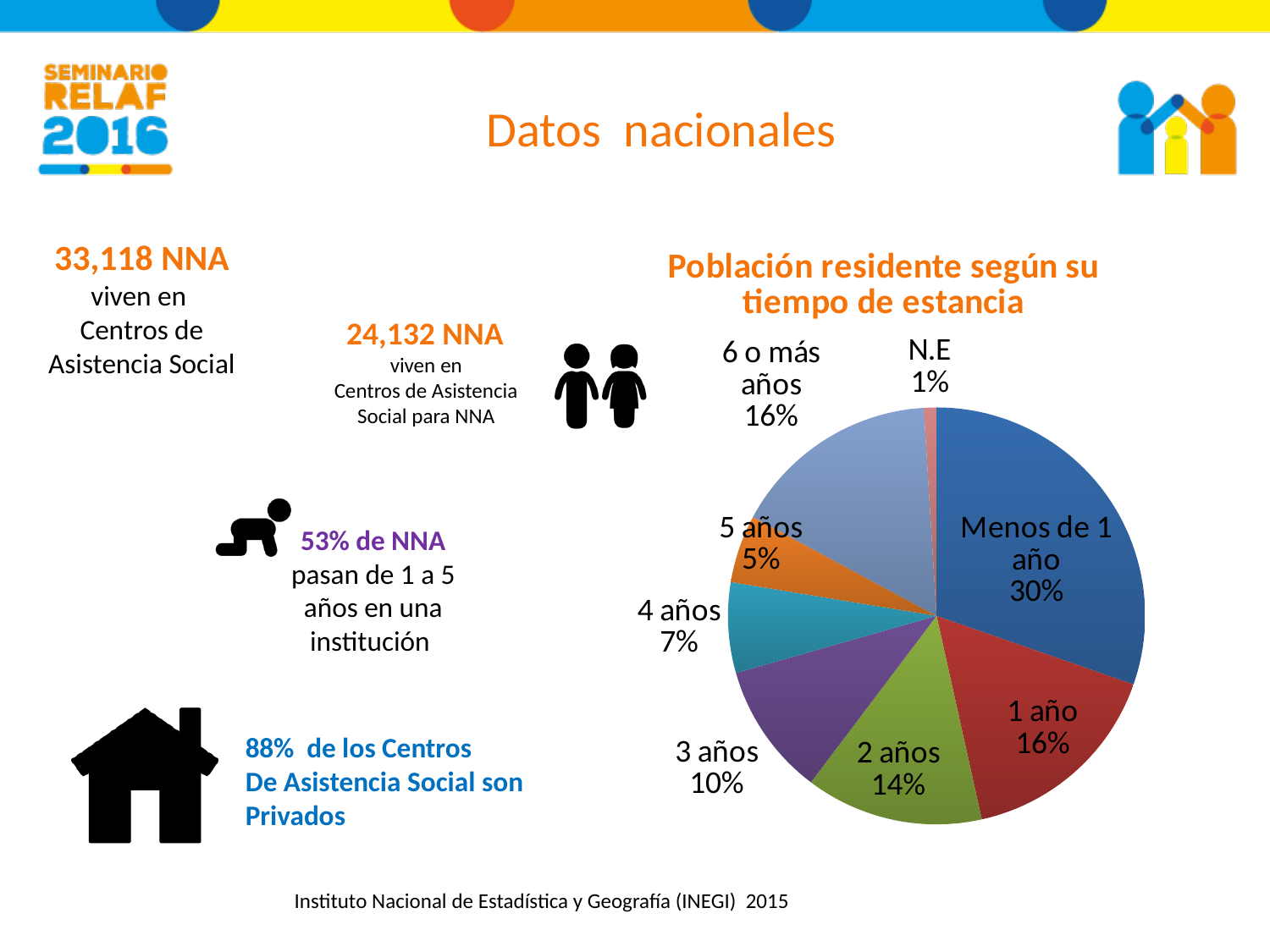
What kind of chart is shown on the slide? pie chart What is the value shown for "2 años"? 14% Which category has the smallest slice of the pie? N.E Which category has the largest slice of the pie? Menos de 1 año What is the value shown for "6 o más años"? 16% What is the difference between the shares for "2 años" and "4 años"? 7% What is the difference between the shares for "Menos de 1 año" and "1 año"? 14% What share of the pie does "Menos de 1 año" represent? 30% Which is larger, the share for "3 años" or the share for "5 años"? 3 años How many slices does the pie chart have? 8 What is the title of the chart? Población residente según su tiempo de estancia What is the value shown for "4 años"? 7%